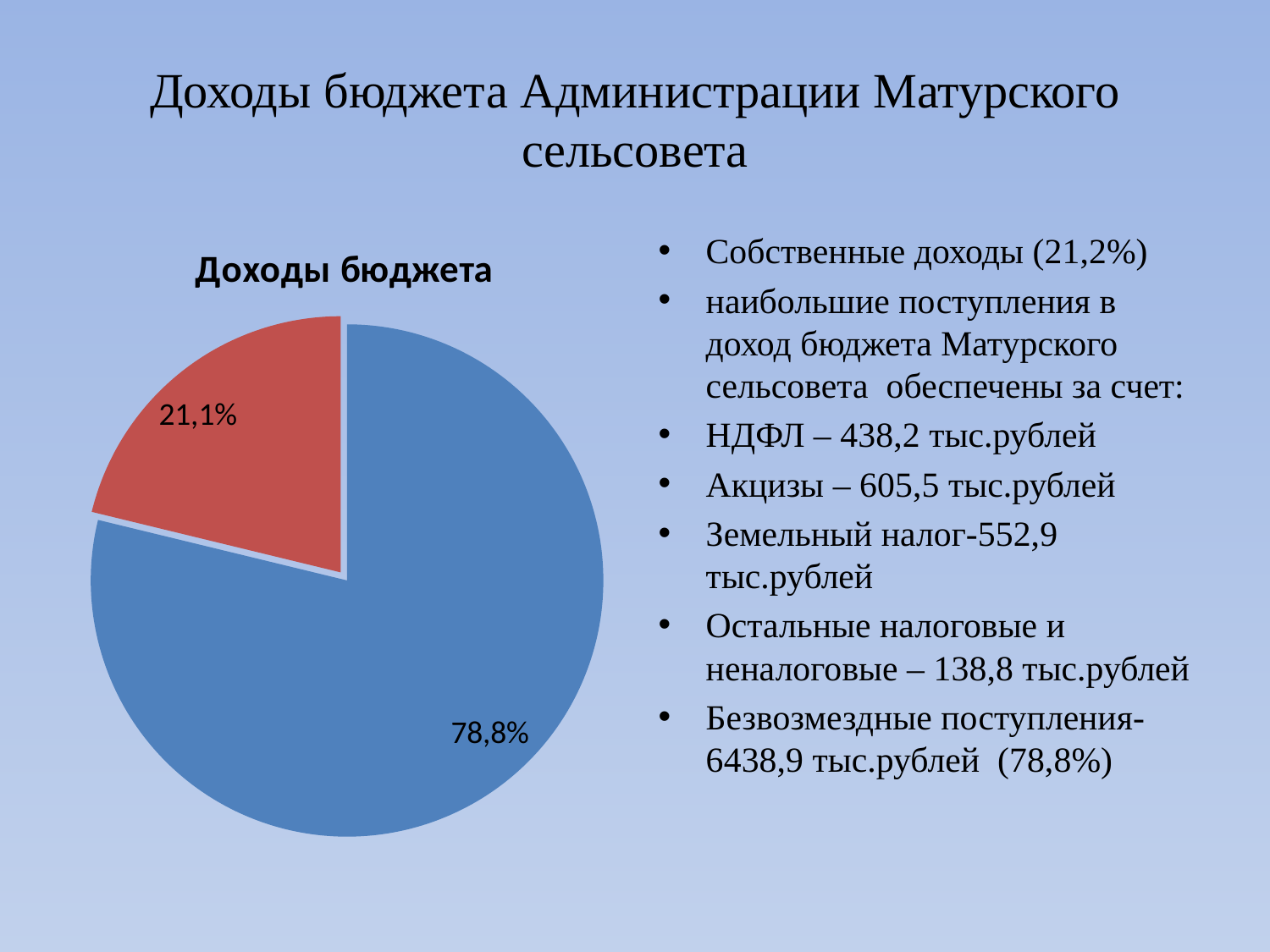
Which slice is larger, the blue one or the red one? the blue one Which slice of the pie chart is the smallest? the red slice (21,1%) What colours are used for the two slices of the pie chart? blue and red What is the title of the chart on the slide? Доходы бюджета What is the difference in percentage points between the blue slice and the red slice? 57,7 What type of chart is shown on the slide? pie chart Which slice of the pie chart is the largest? the blue slice (78,8%) How many slices does the pie chart have? 2 What percentage is shown on the red slice of the pie chart? 21,1% What share of the pie does the red slice represent? 21,1% What percentage is shown on the blue slice of the pie chart? 78,8%